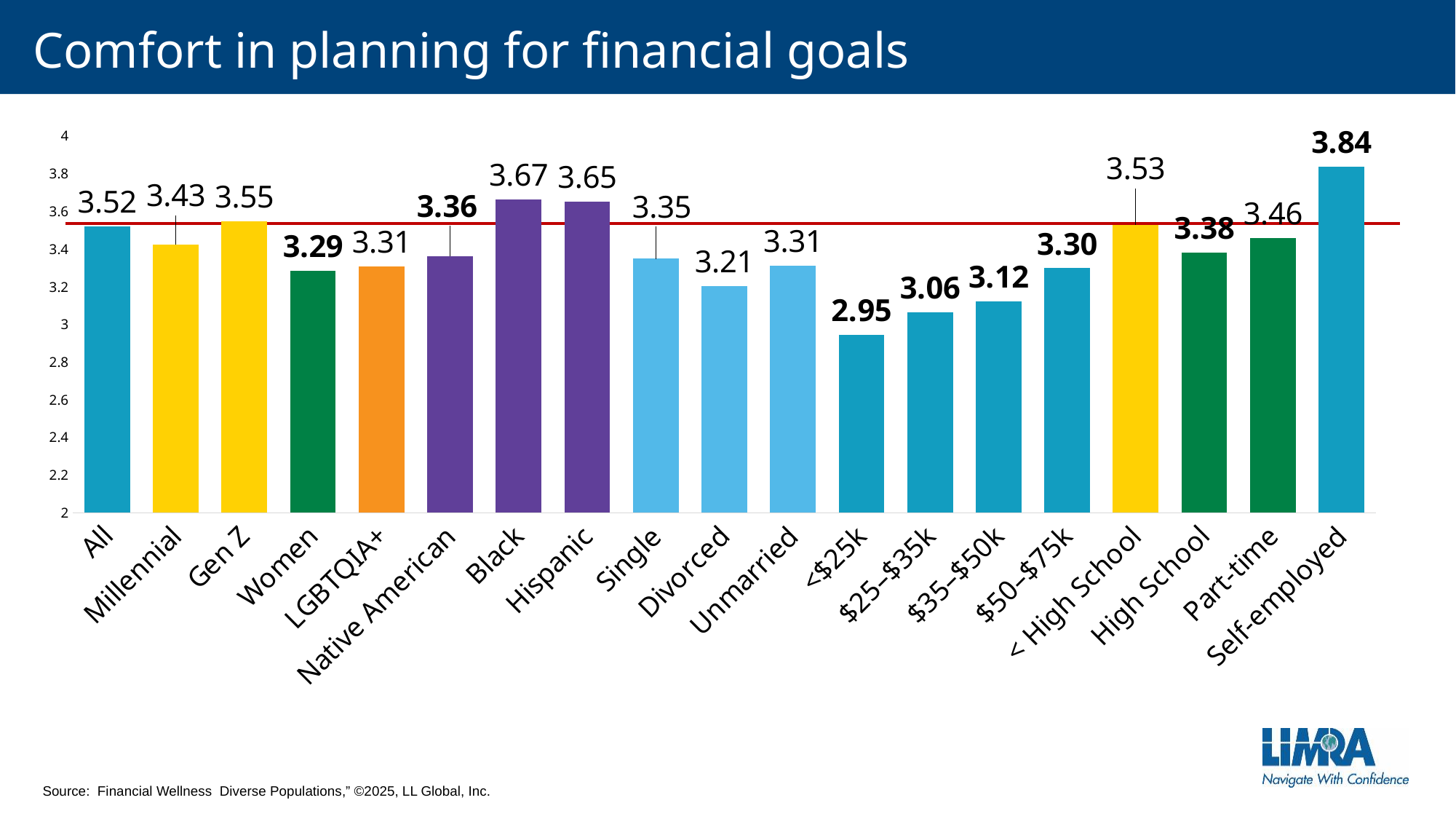
What is the difference between the values for Self-employed and All? 0.32 Which is larger, the value for Black or the value for Hispanic? Black What is the difference between the values for Gen Z and Millennial? 0.12 What is the value for Self-employed? 3.84 Is the value for <$25k greater or less than 3? less What is the value for the All category? 3.52 What kind of chart is shown on the slide? Bar chart What is the value for Divorced? 3.21 Which category has the lowest value? <$25k What is the value for Black? 3.67 How many categories are shown on the chart? 19 Which category has the highest value? Self-employed